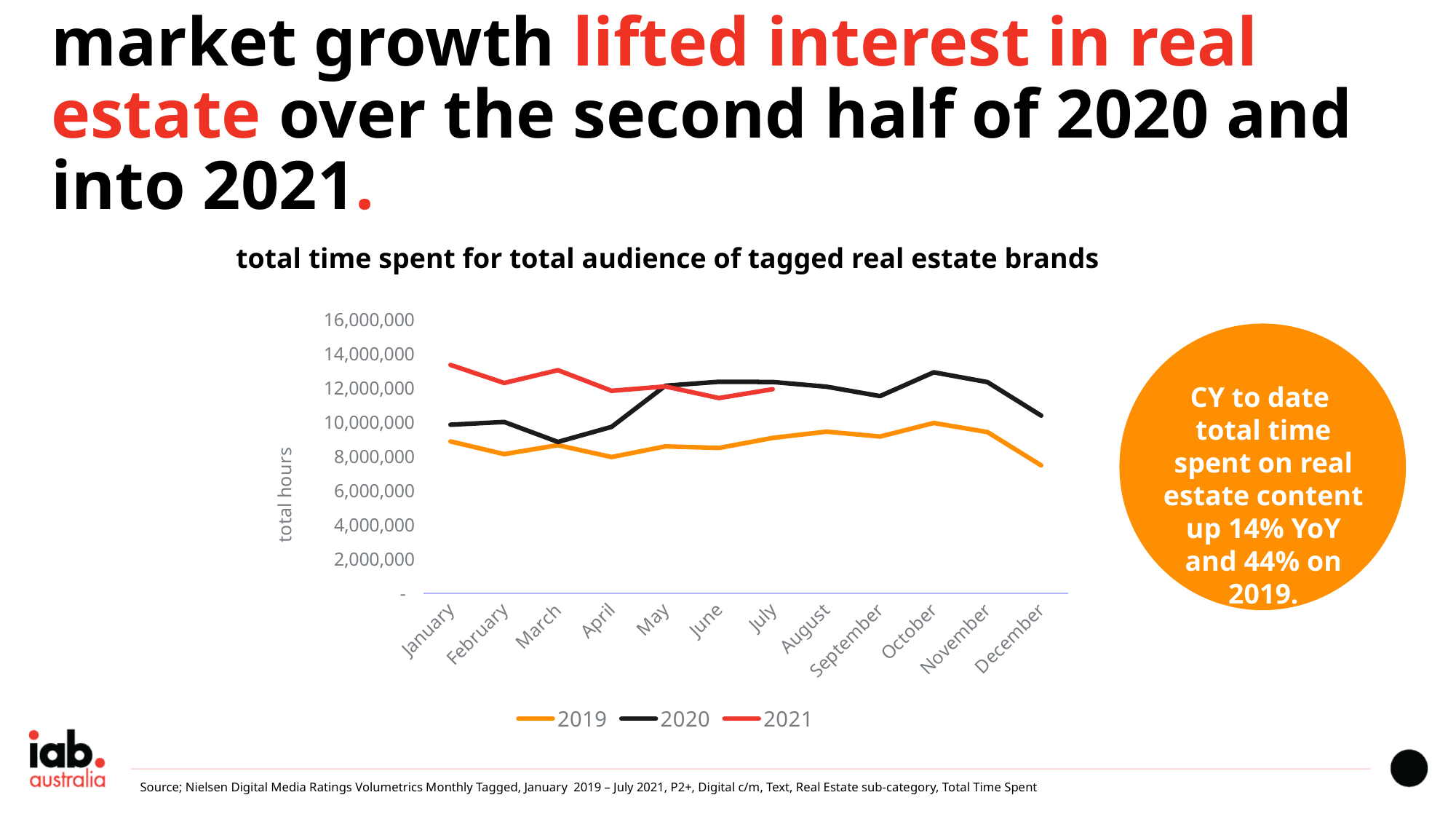
Is the value for 2019 in December greater or less than 8,000,000? less What is the label on the y axis? total hours In which month is the 2020 series at its lowest? March In which month is the 2019 series at its lowest? December How many months are shown along the x axis? 12 Which is larger in January, the 2019 value or the 2021 value? 2021 Which is larger in December, the 2019 value or the 2020 value? 2020 Is the value for 2021 in January greater or less than 12,000,000? greater Is the value for 2020 in March greater or less than 10,000,000? less How many series does the legend list? 3 How many months of data are plotted for the 2021 series? 7 What kind of chart is shown on the slide? line chart